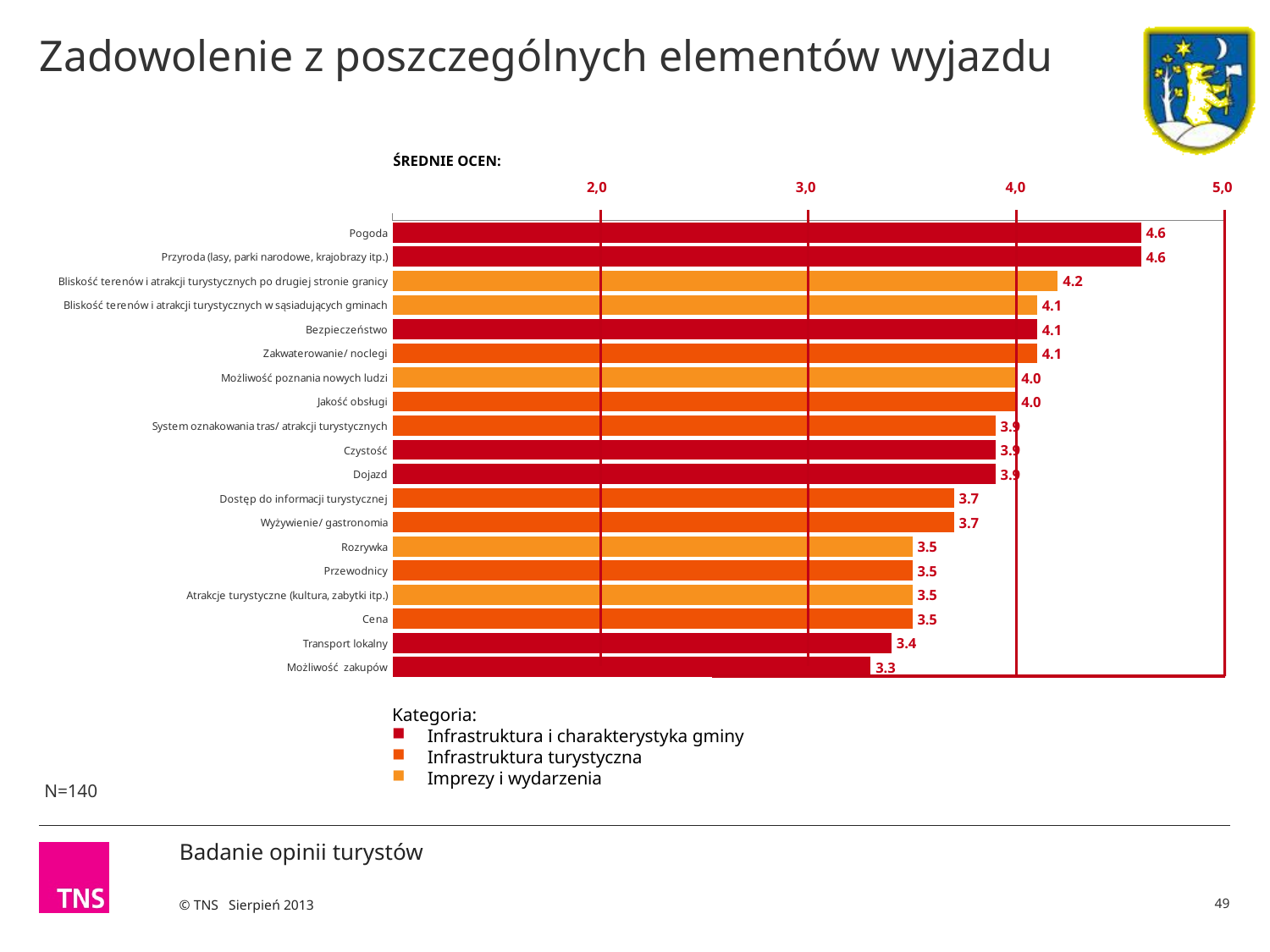
What is the average rating for Bezpieczeństwo? 4.1 What is the difference between the average rating for Bliskość terenów i atrakcji turystycznych po drugiej stronie granicy and for Dojazd? 0.3 Is the average rating for Wyżywienie/ gastronomia greater or less than 4,0? less What is the average rating for Pogoda? 4.6 How many elements of the trip are rated in the chart? 19 What is the average rating for Transport lokalny? 3.4 Which has a higher average rating, Jakość obsługi or Rozrywka? Jakość obsługi Which element has the lowest average rating? Możliwość zakupów How many categories does the legend (Kategoria) list? 3 What type of chart is shown on the slide? bar chart What is the difference between the average rating for Pogoda and the average rating for Możliwość zakupów? 1.3 What is the average rating for Cena? 3.5